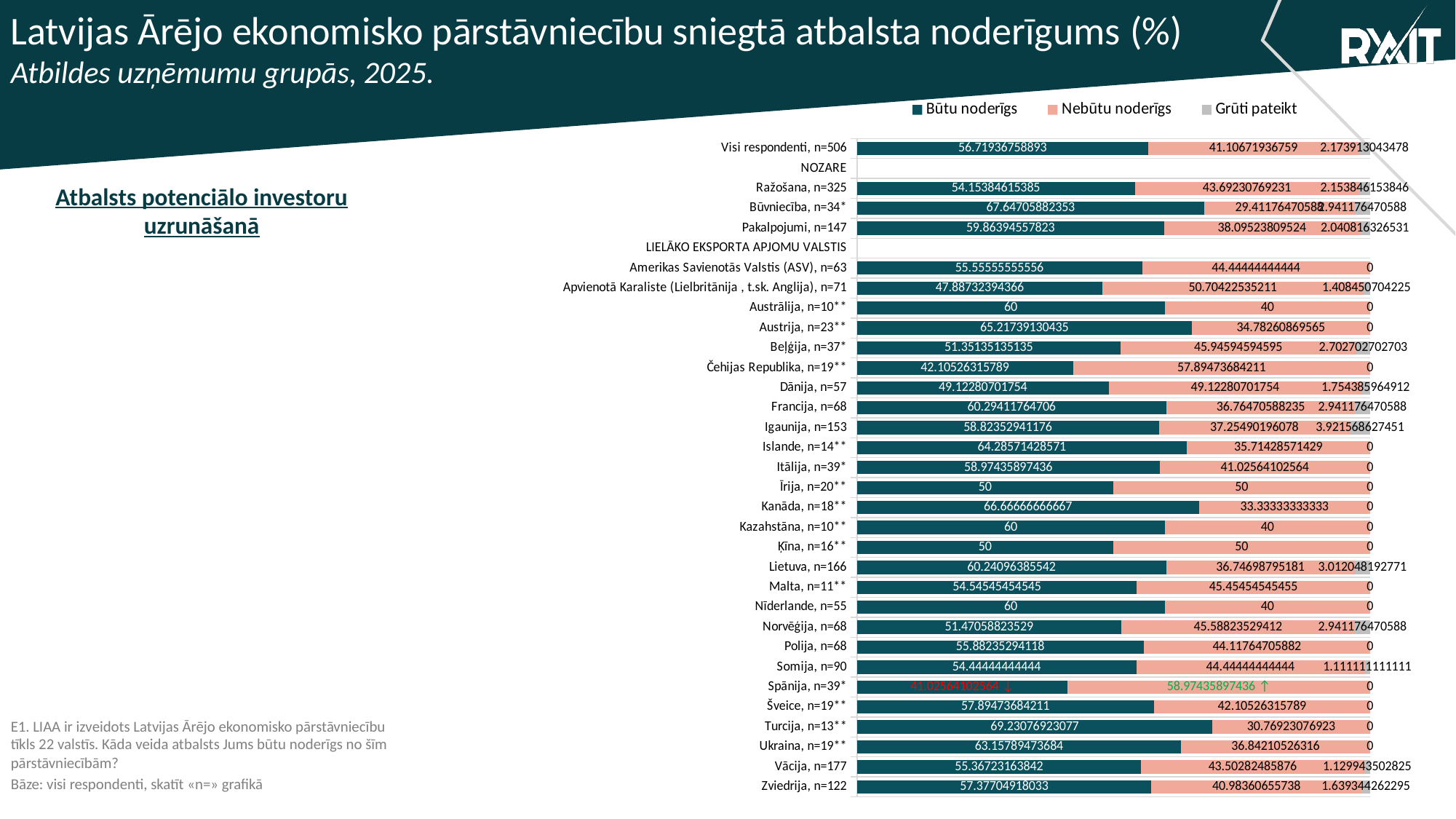
How many series does the legend list? 3 What is the value of "Nebūtu noderīgs" for "Spānija, n=39*"? 58.97435897436 What is the value of "Nebūtu noderīgs" for "Austrālija, n=10**"? 40 What is the difference between "Būtu noderīgs" and "Nebūtu noderīgs" for "Austrālija, n=10**"? 20 What kind of chart is shown on the slide? Stacked bar chart For "Apvienotā Karaliste (Lielbritānija , t.sk. Anglija), n=71", which is larger: "Būtu noderīgs" or "Nebūtu noderīgs"? Nebūtu noderīgs Which category has the lowest "Būtu noderīgs" value? Spānija, n=39* What is the value of "Būtu noderīgs" for "Visi respondenti, n=506"? 56.71936758893 How many countries are listed under the "LIELĀKO EKSPORTA APJOMU VALSTIS" group? 27 What is the value of "Būtu noderīgs" for "Turcija, n=13**"? 69.23076923077 What is the value of "Grūti pateikt" for "Lietuva, n=166"? 3.012048192771 Which category has the highest "Būtu noderīgs" value? Turcija, n=13**